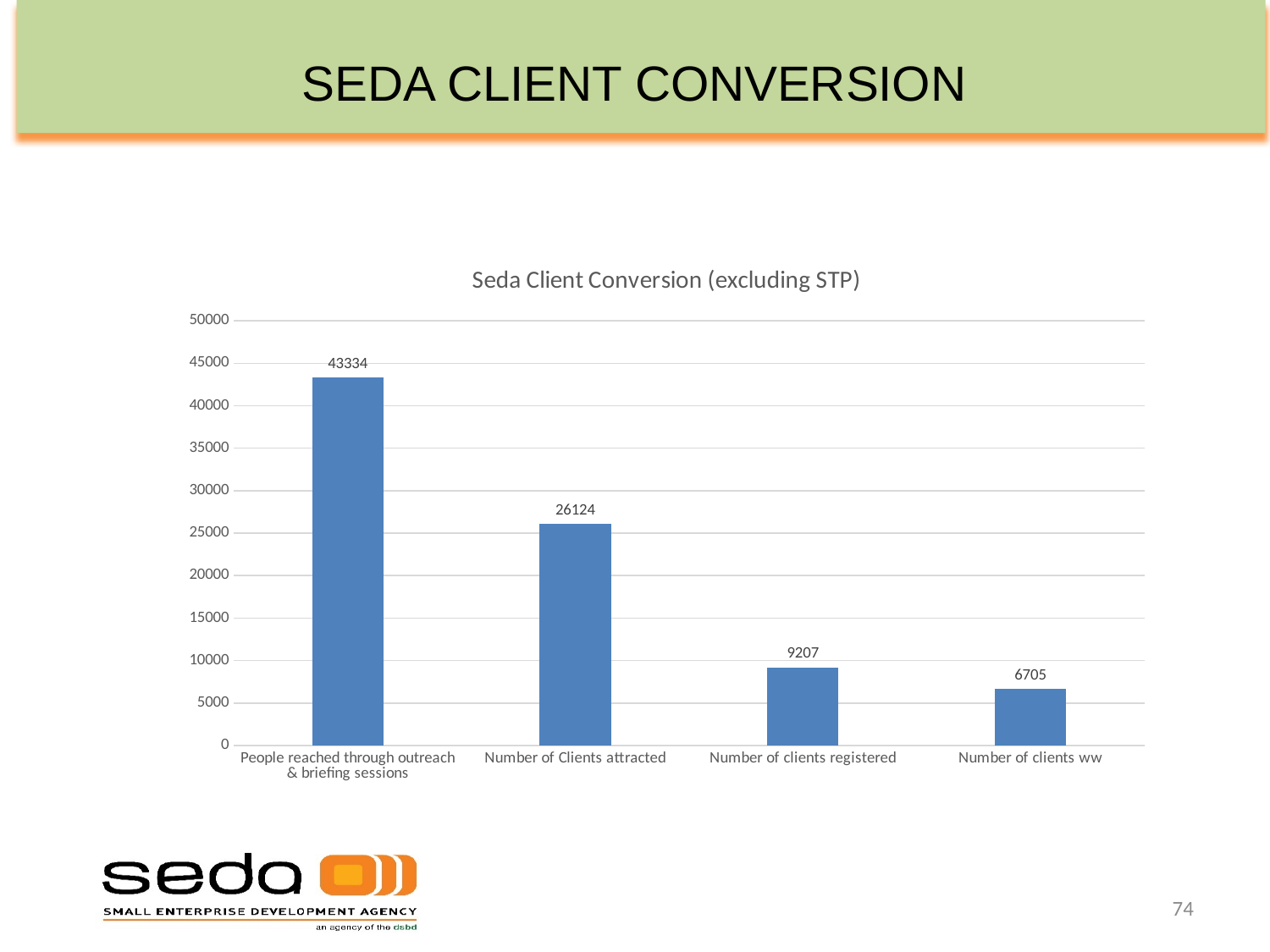
What is the difference between Number of clients registered and Number of clients ww? 2502 What is the value for Number of clients registered? 9207 What is the difference between People reached through outreach & briefing sessions and Number of Clients attracted? 17210 Which category has the lowest value? Number of clients ww Do the values rise or fall from left to right along the x axis? Fall What is the value for Number of Clients attracted? 26124 What kind of chart is shown on the slide? Bar chart How many categories are shown in the chart? 4 What is the value for Number of clients ww? 6705 Which is larger, Number of Clients attracted or Number of clients registered? Number of Clients attracted What is the value for People reached through outreach & briefing sessions? 43334 Which category has the highest value? People reached through outreach & briefing sessions